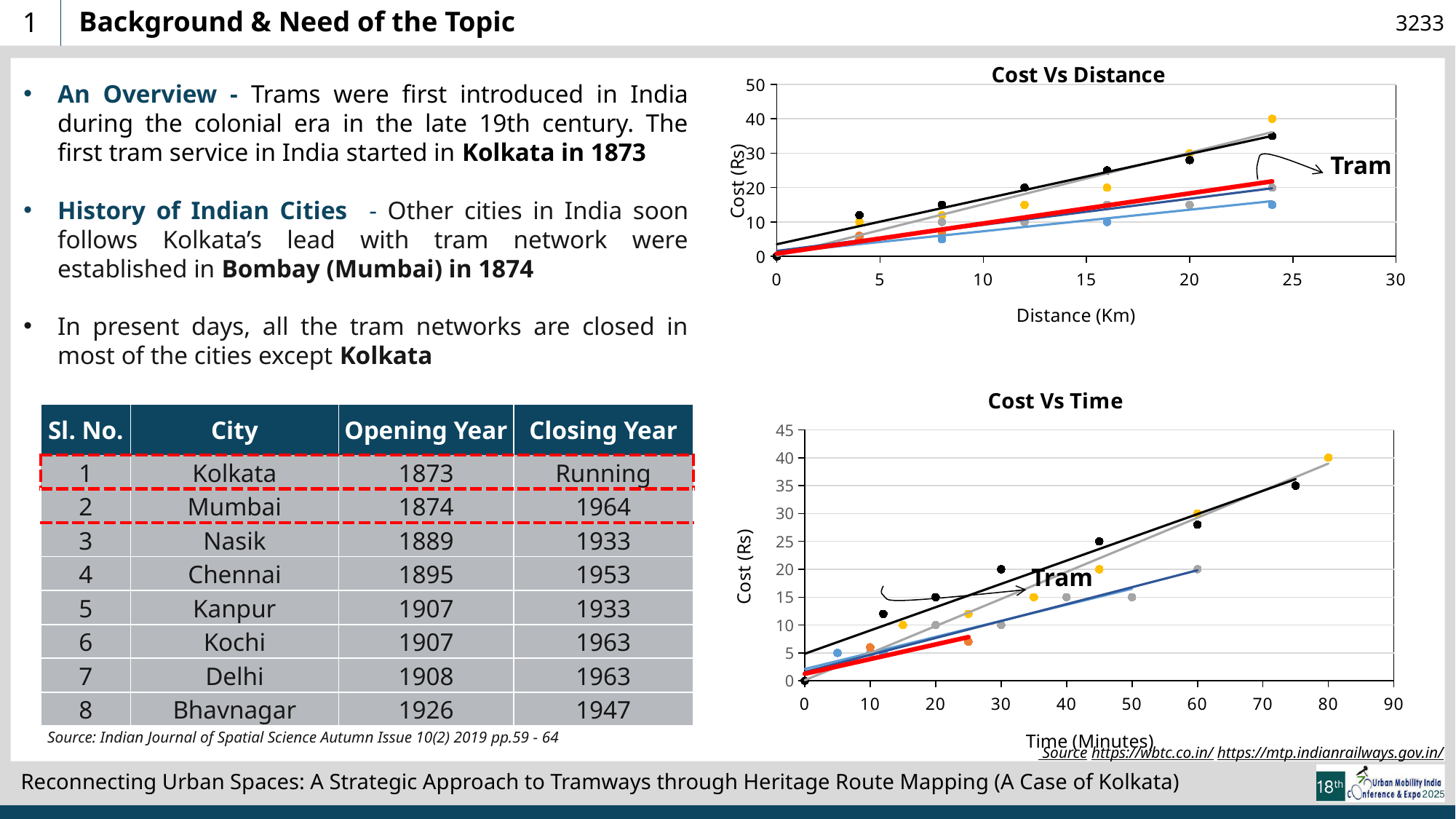
In the 'Cost Vs Distance' chart, is the Tram (red) line's value at 24 km greater or less than 30? less In the 'Cost Vs Distance' chart, do the cost values rise or fall as distance increases? rise What is the x-axis label of the 'Cost Vs Distance' chart? Distance (Km) In the 'Cost Vs Distance' chart, which coloured line is labelled 'Tram'? the red line In the 'Cost Vs Time' chart, is the black series' value at 30 minutes greater or less than 15? greater In the 'Cost Vs Distance' chart, is the highest plotted cost value greater or less than 30? greater What kind of chart is the 'Cost Vs Time' chart? scatter chart How many charts are shown on the slide? 2 In the 'Cost Vs Time' chart, do the cost values rise or fall as time increases? rise What kind of chart is the 'Cost Vs Distance' chart? scatter chart